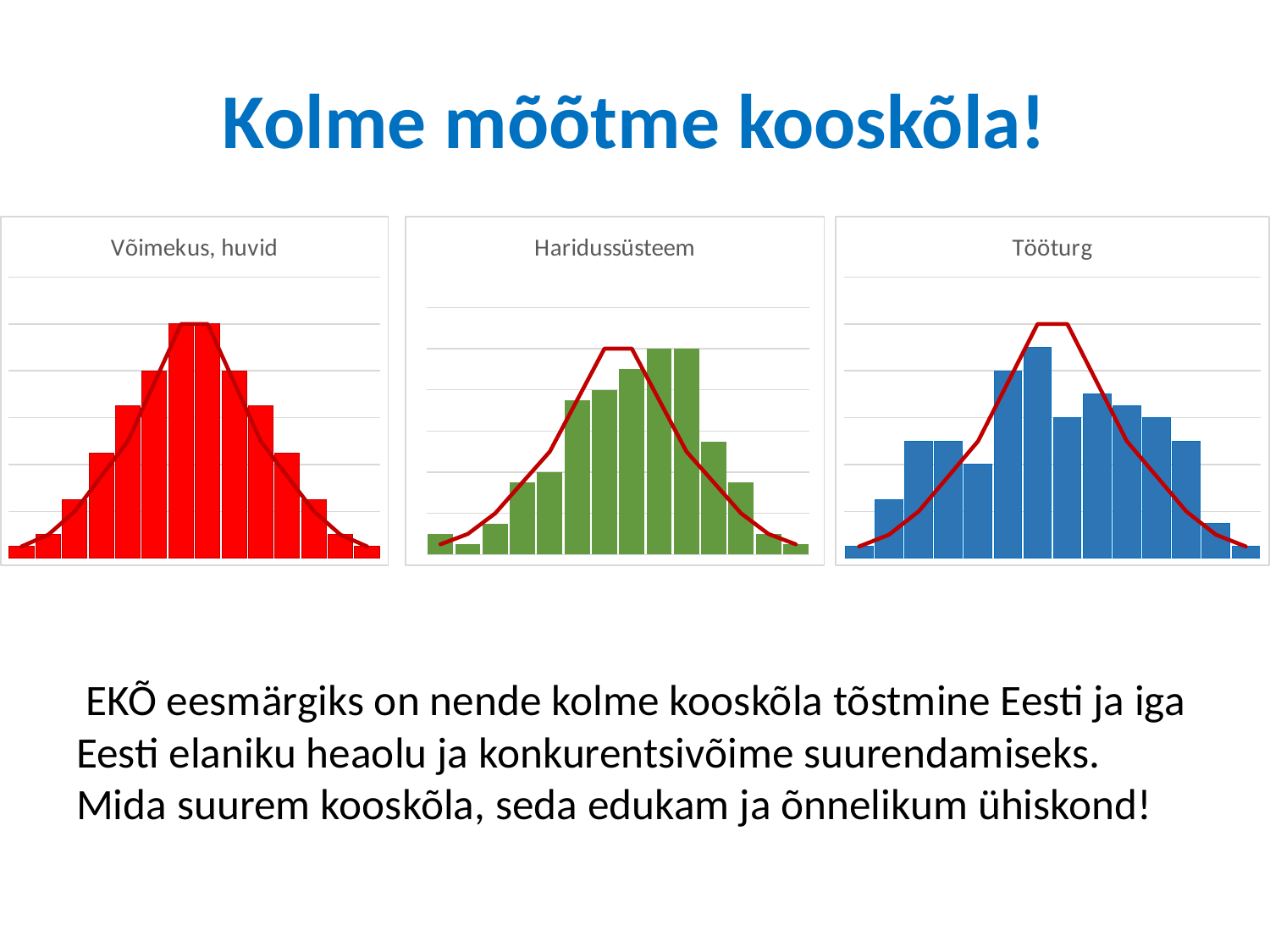
In the chart titled "Võimekus, huvid", do the bar values rise and then fall from left to right, or rise steadily? rise and then fall What kind of chart is the one titled "Tööturg"? combination bar and line chart In the chart titled "Haridussüsteem", do the bar values rise or fall over the first six bars from the left? rise How many charts are shown on the slide? 3 What kind of chart is the one titled "Võimekus, huvid"? combination bar and line chart What colour are the bars in the chart titled "Haridussüsteem"? green What is the title of the middle chart? Haridussüsteem In the chart titled "Tööturg", do the bar values rise or fall over the last four bars on the right? fall